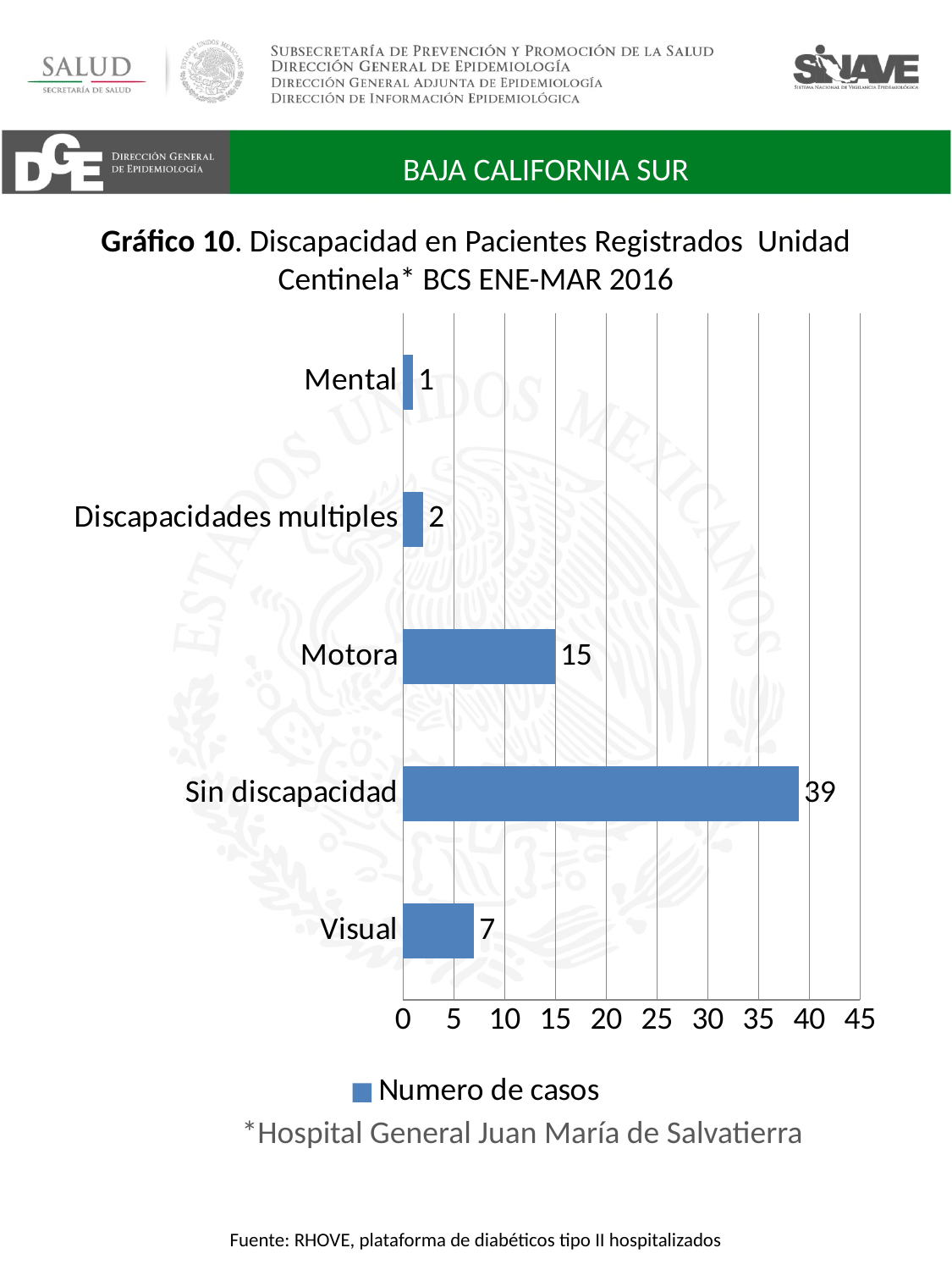
Is the value for Sin discapacidad greater or less than 35? greater Which category has the lowest number of cases? Mental What is the number of cases for Sin discapacidad? 39 Which has more cases, Motora or Visual? Motora What is the number of cases for Discapacidades multiples? 2 Which category has the highest number of cases? Sin discapacidad What is the number of cases for Motora? 15 How many categories are shown in the chart? 5 What is the number of cases for Visual? 7 What series name does the legend show? Numero de casos What is the difference in number of cases between Sin discapacidad and Motora? 24 What kind of chart is shown on the slide? Bar chart